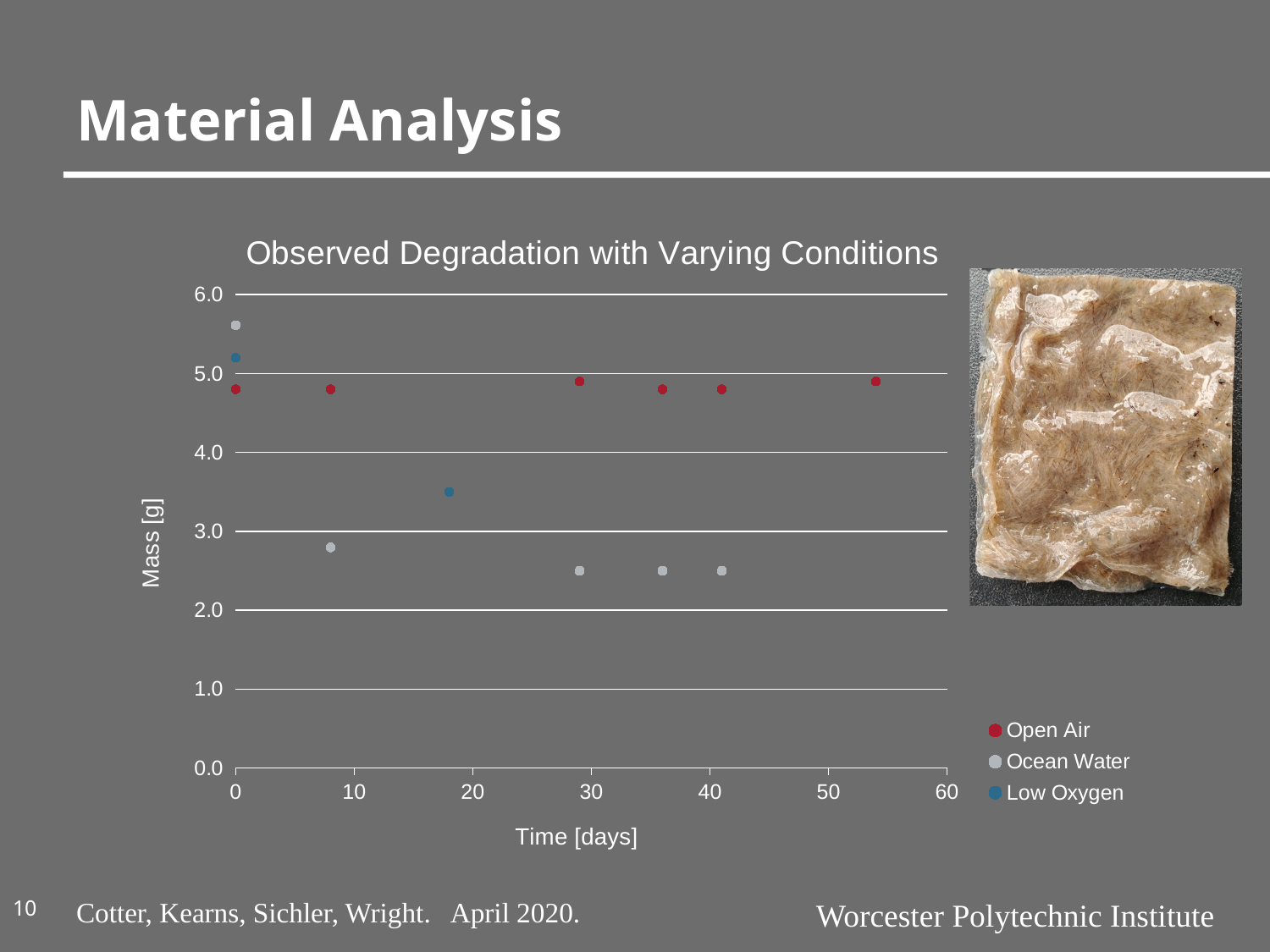
At around day 36, which series has the larger mass, Open Air or Ocean Water? Open Air Is the Open Air value at day 0 greater or less than 5.0? less Is the Ocean Water value at around day 29 greater or less than 3.0? less What kind of chart is shown on the slide? scatter chart What is the label of the y axis? Mass [g] How many data points are plotted for the Low Oxygen series? 2 Do the Ocean Water values rise or fall as time increases? fall What is the title of the chart? Observed Degradation with Varying Conditions How many data points are plotted for the Open Air series? 6 Is the Low Oxygen value at around day 18 greater or less than 3.0? greater How many series does the legend list? 3